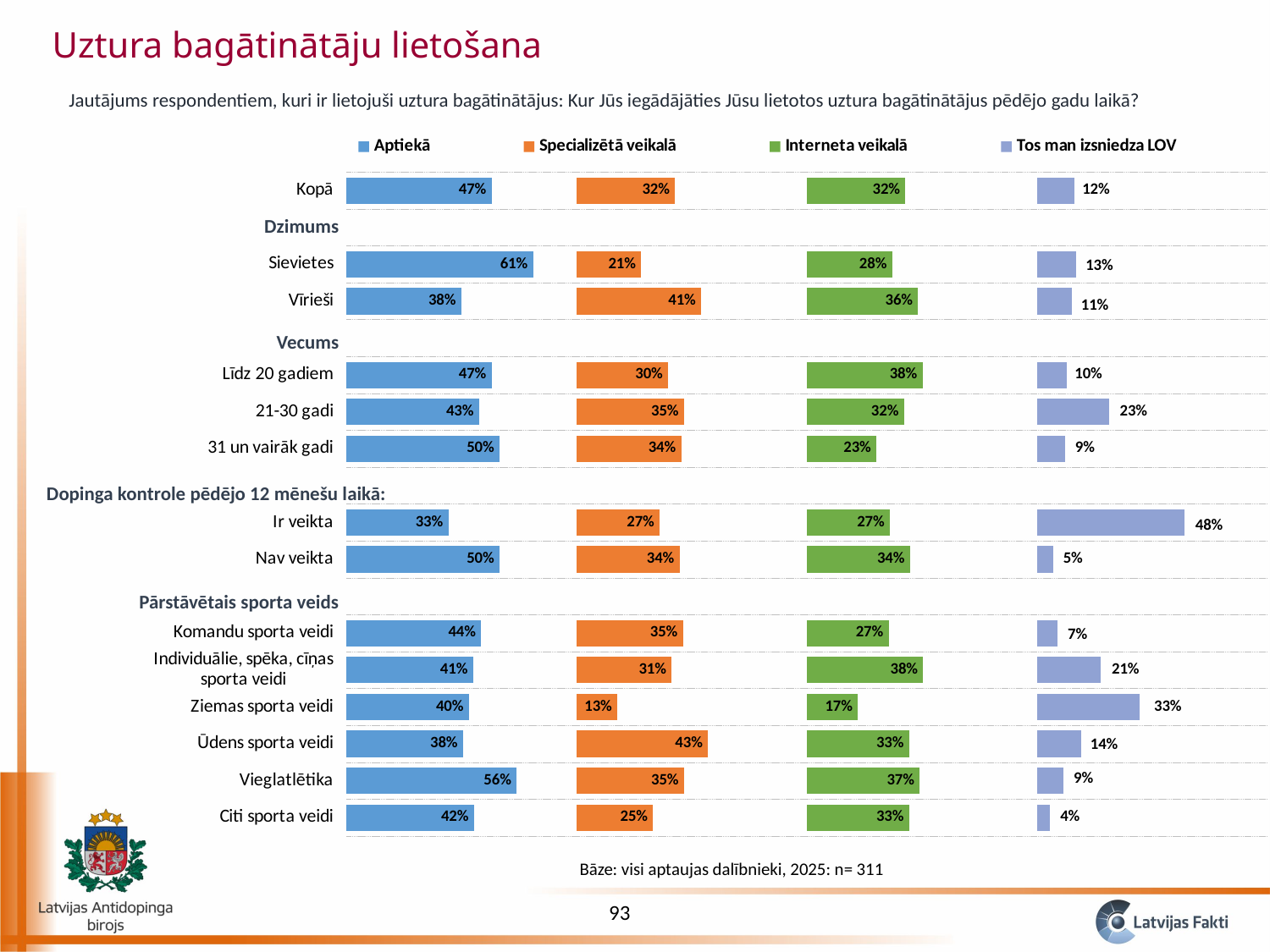
Which is larger for Ūdens sporta veidi: the Aptiekā value or the Specializētā veikalā value? Specializētā veikalā What is the value for Ir veikta in the Tos man izsniedza LOV series? 48% What is the difference between the Aptiekā values for Sievietes and Vīrieši? 23% What is the value for Sievietes in the Aptiekā series? 61% Which series is shown in orange in the legend? Specializētā veikalā What is the value for Ziemas sporta veidi in the Specializētā veikalā series? 13% What is the difference between the Tos man izsniedza LOV values for Ir veikta and Nav veikta? 43% What is the value for Kopā in the Interneta veikalā series? 32% How many series does the legend list? 4 Which category has the lowest value in the Tos man izsniedza LOV series? Citi sporta veidi What kind of chart is shown on the slide? Bar chart Which category has the highest value in the Aptiekā series? Sievietes